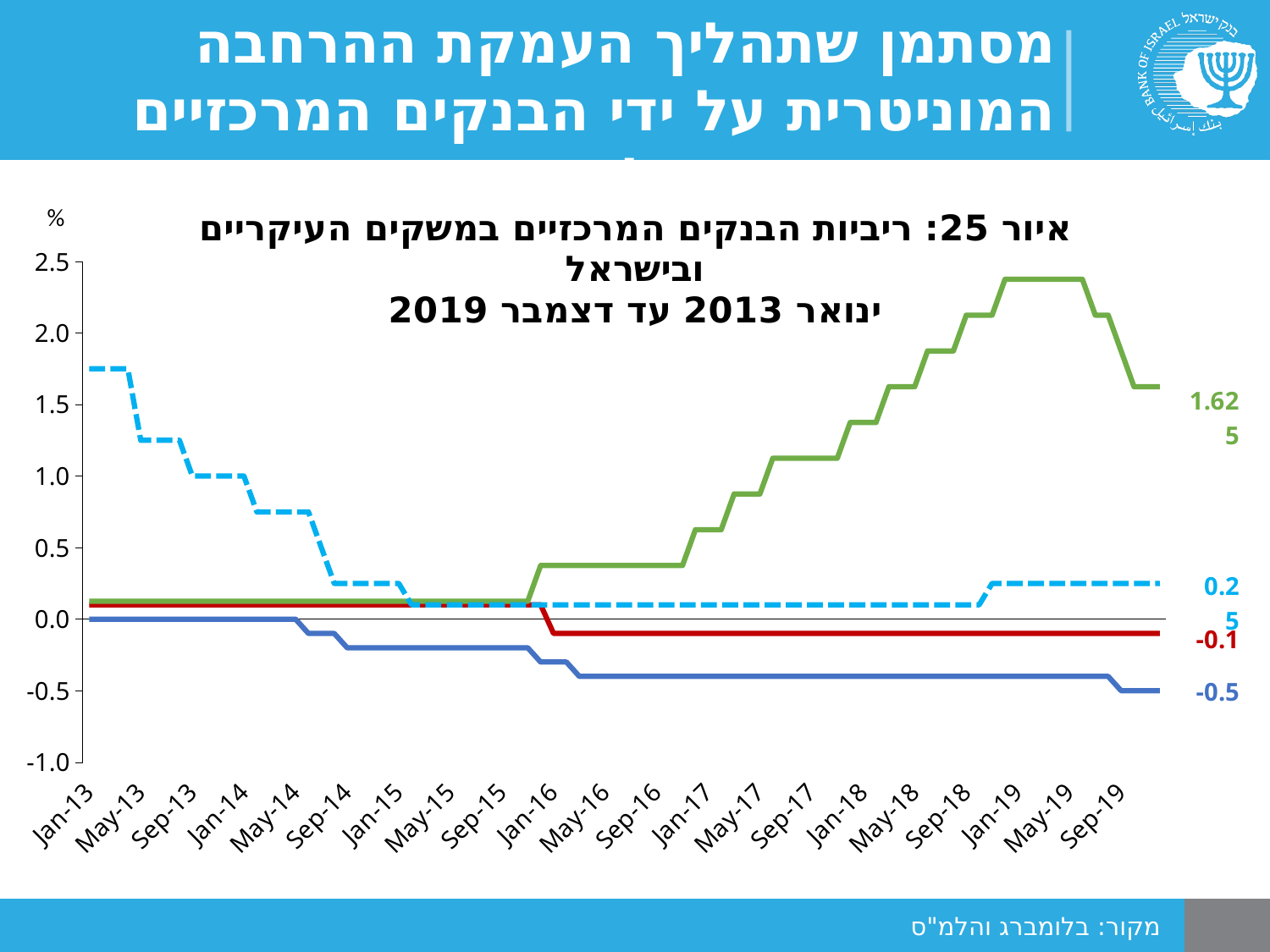
At the end of the chart, which is larger: the red line's value or the solid dark-blue line's value? the red line What is the final value labelled at the end of the dashed light-blue line? 0.25 Which line ends at the lowest value at the right edge of the chart? the solid dark-blue line Is the value of the dashed light-blue line at Jan-13 greater or less than 1.5? greater What is the final value labelled at the end of the green line? 1.625 How many lines are plotted on the chart? 4 Does the green line rise or fall between Jan-16 and Jan-19? rise What is the final value labelled at the end of the solid dark-blue line? -0.5 What kind of chart is shown on the slide? line chart What is the final value labelled at the end of the red line? -0.1 Which line ends at the highest value at the right edge of the chart? the green line What is the difference between the final values of the green line (1.625) and the solid dark-blue line (-0.5)? 2.125